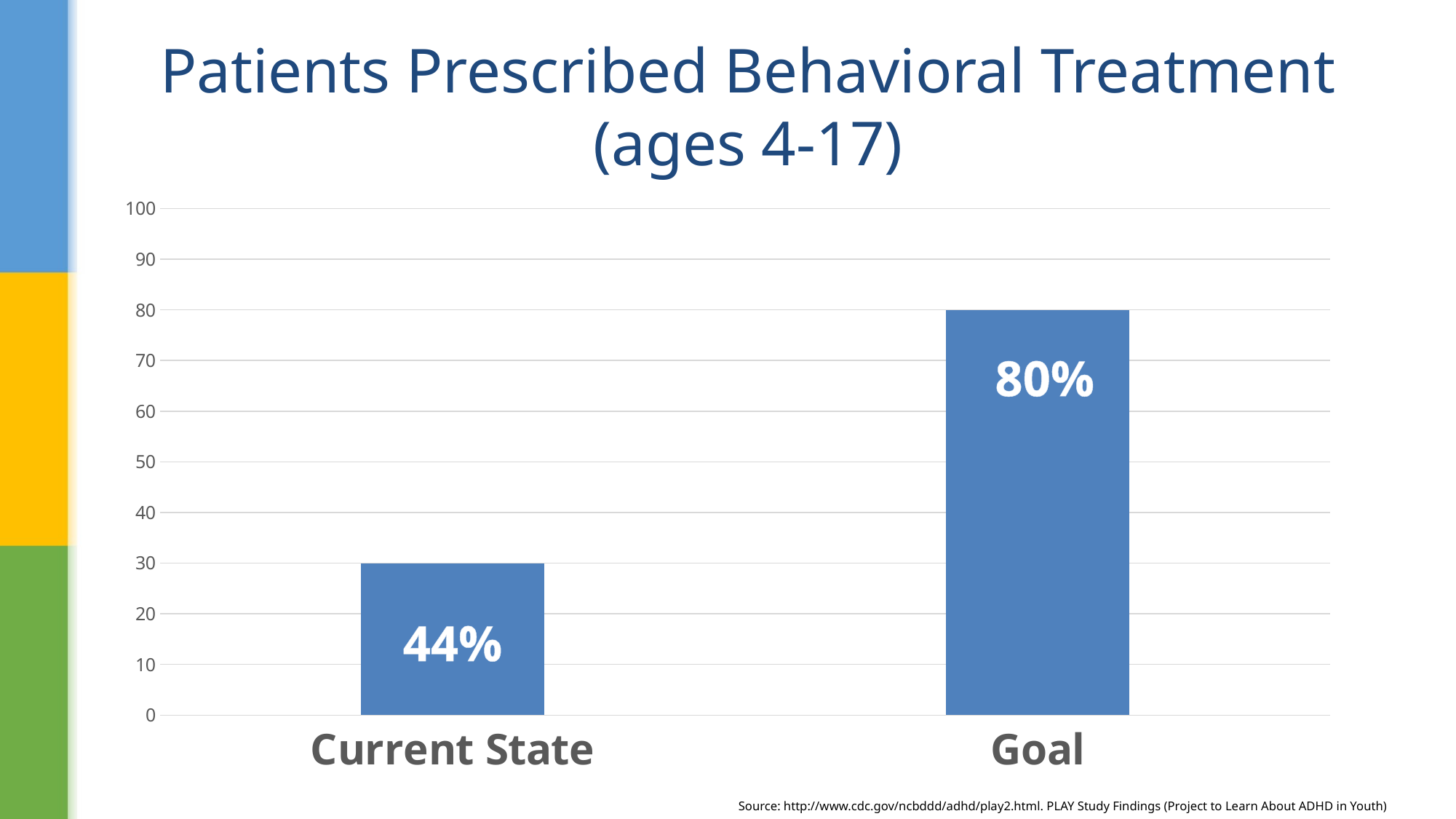
What is the value shown for Goal? 80% What is the maximum value shown on the vertical axis? 100 Which category has the highest value? Goal Is the value for Goal greater or less than 70? greater What is the title of the chart? Patients Prescribed Behavioral Treatment (ages 4-17) Which category has the lowest value? Current State What is the difference between the Goal value and the Current State value? 36% How many categories are shown on the x axis? 2 What kind of chart is shown on the slide? Bar chart Which category has the higher value, Current State or Goal? Goal What is the value shown for Current State? 44%